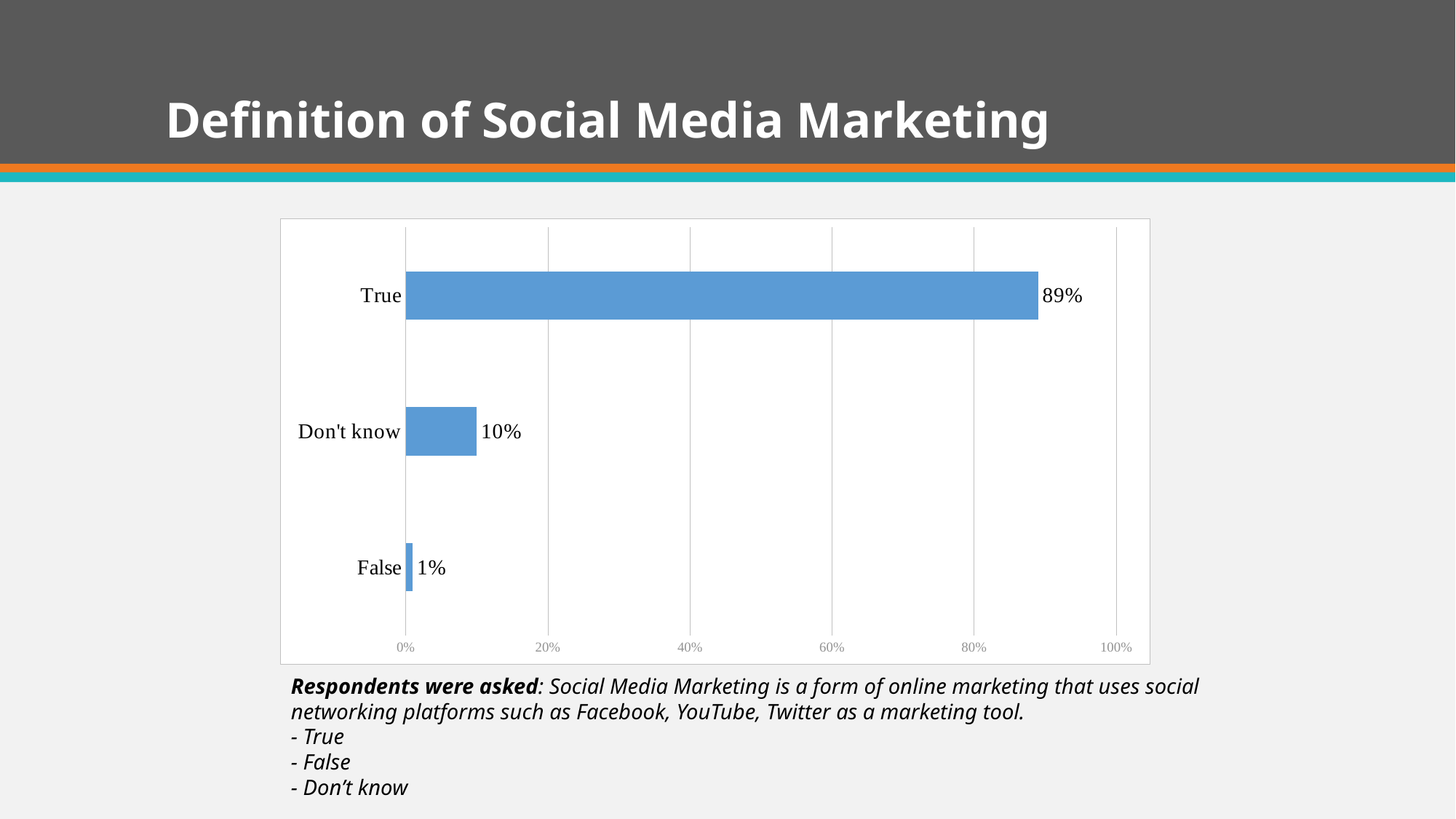
Is the value for True greater or less than 80%? greater What kind of chart is shown on the slide? Bar chart Which response category has the lowest value? False Which response category has the highest value? True What is the difference in percentage points between True and Don't know? 79 What is the maximum value shown on the horizontal axis? 100% Which is larger, the value for Don't know or the value for False? Don't know What percentage of respondents answered Don't know? 10% What percentage of respondents answered True? 89% What percentage of respondents answered False? 1% What is the difference in percentage points between Don't know and False? 9 How many response categories are shown in the chart? 3